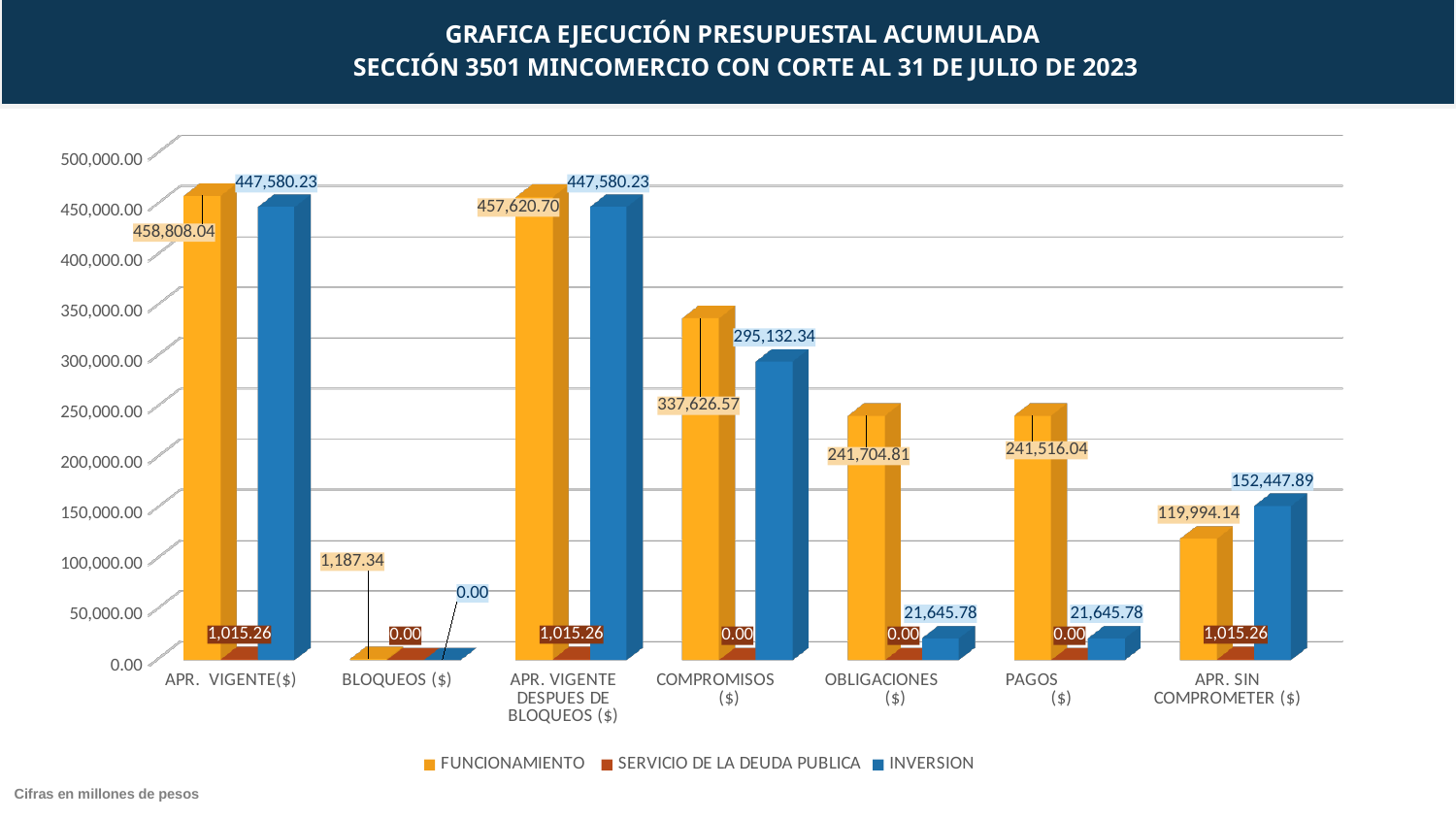
What is the difference between the FUNCIONAMIENTO and INVERSION values for COMPROMISOS ($)? 42,494.23 What is the difference between the FUNCIONAMIENTO values for APR. VIGENTE($) and APR. VIGENTE DESPUES DE BLOQUEOS ($)? 1,187.34 How many categories are shown on the x axis? 7 What is the FUNCIONAMIENTO value for BLOQUEOS ($)? 1,187.34 Which category has the lowest FUNCIONAMIENTO value? BLOQUEOS ($) Is the FUNCIONAMIENTO value for COMPROMISOS ($) greater or less than 300,000.00? greater How many series does the legend list? 3 What is the FUNCIONAMIENTO value for APR. VIGENTE($)? 458,808.04 For APR. SIN COMPROMETER ($), which is larger: FUNCIONAMIENTO or INVERSION? INVERSION What is the SERVICIO DE LA DEUDA PUBLICA value for APR. SIN COMPROMETER ($)? 1,015.26 For OBLIGACIONES ($), which is larger: FUNCIONAMIENTO or INVERSION? FUNCIONAMIENTO What is the INVERSION value for COMPROMISOS ($)? 295,132.34